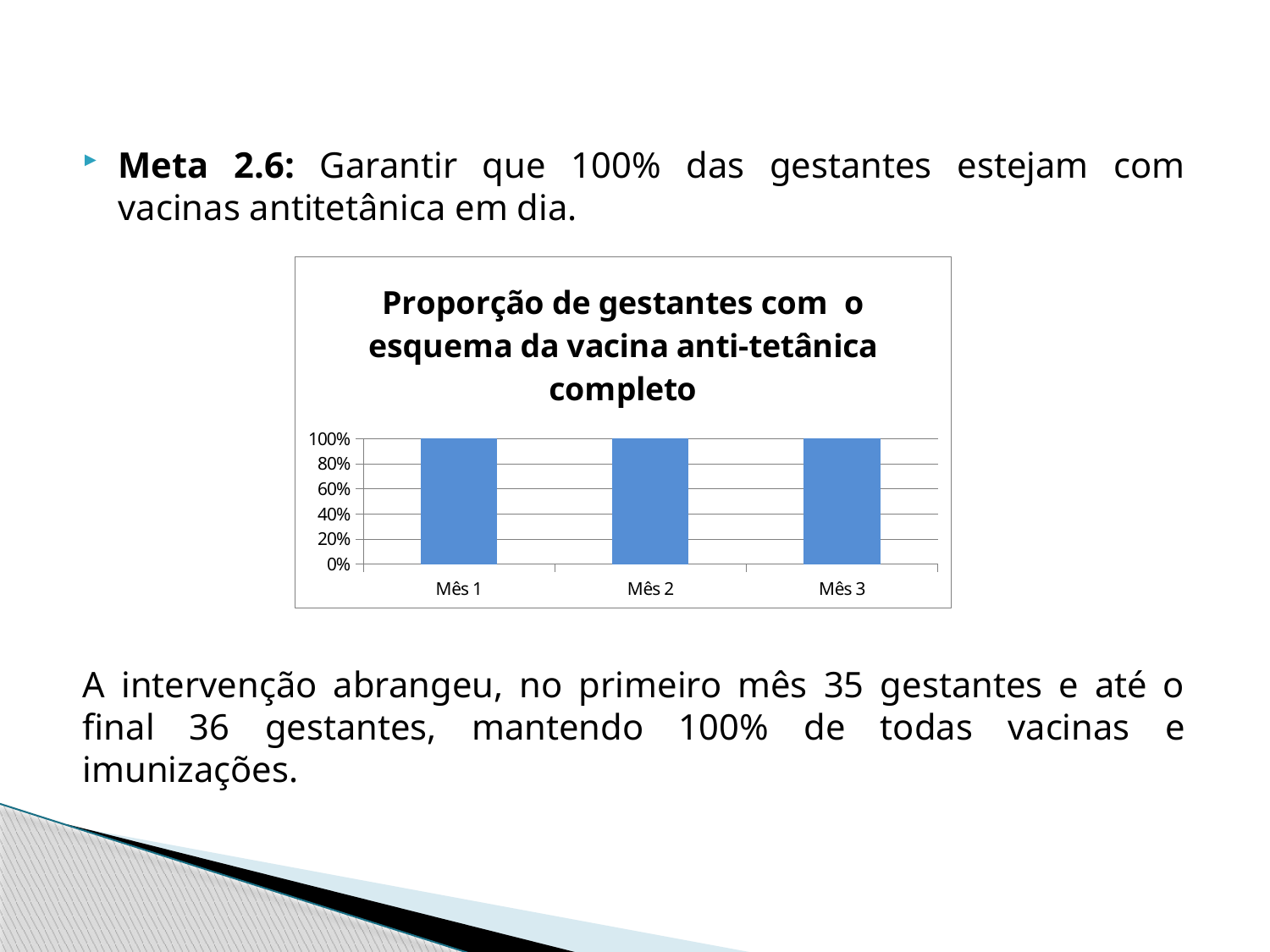
What colour are the bars in the chart? Blue What is the value for Mês 1 in the chart? 100% Is the value for Mês 1 greater or less than 60%? greater Do the values rise, fall or stay the same from Mês 1 to Mês 3? Stay the same What is the value for Mês 2 in the chart? 100% Is the value for Mês 2 greater or less than 80%? greater How many categories are shown on the x axis of the chart? 3 What is the difference between the values for Mês 1 and Mês 3? 0% What is the highest value shown on the y axis of the chart? 100% What kind of chart is shown on the slide? Bar chart What is the title of the chart? Proporção de gestantes com o esquema da vacina anti-tetânica completo What is the value for Mês 3 in the chart? 100%